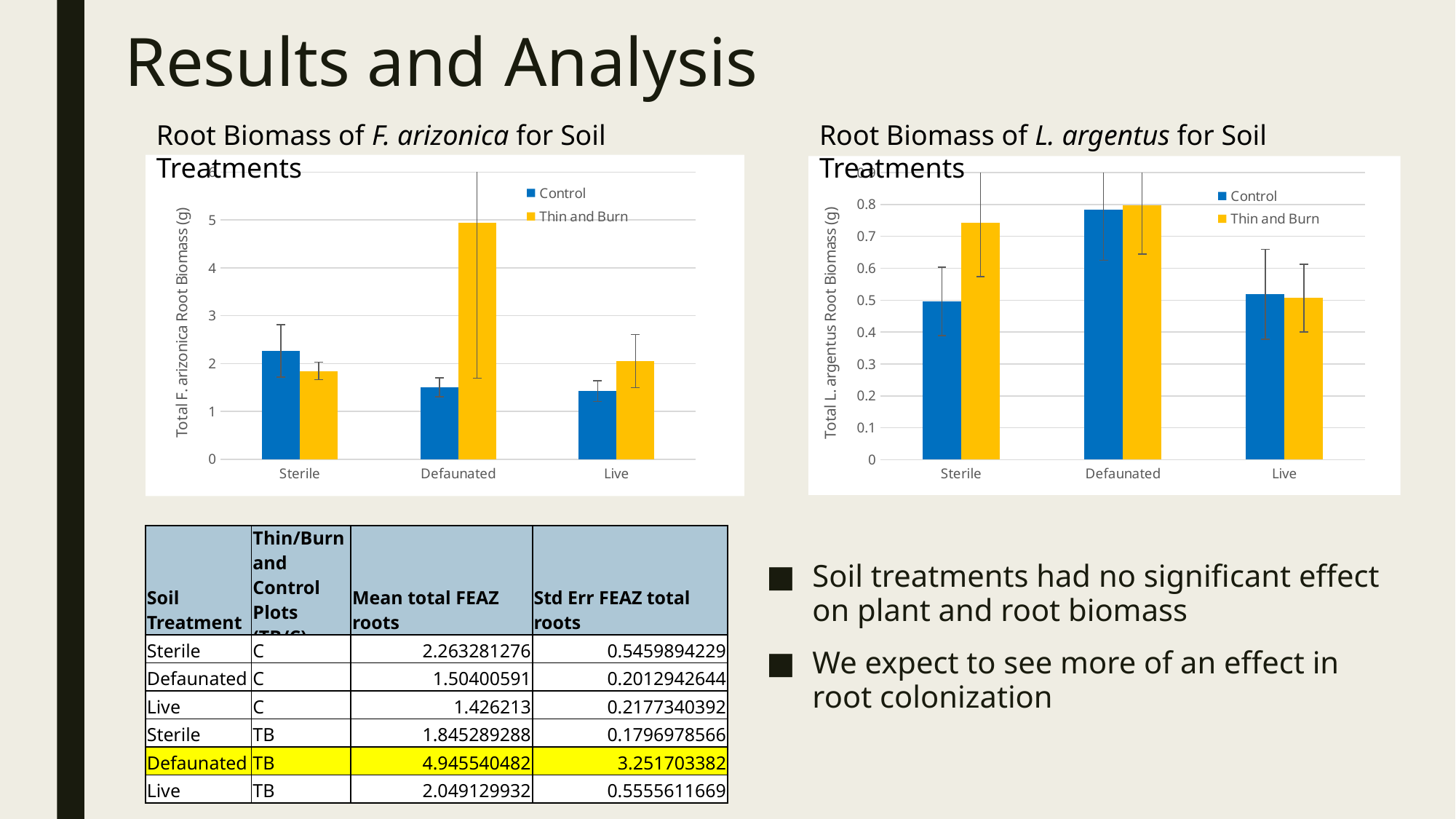
What is the y-axis title of the 'Root Biomass of L. argentus for Soil Treatments' chart? Total L. argentus Root Biomass (g) In the 'Root Biomass of L. argentus for Soil Treatments' chart, which category has the highest Control bar? Defaunated In the 'Root Biomass of F. arizonica for Soil Treatments' chart, is the Thin and Burn value for Defaunated greater or less than 4? greater In the 'Root Biomass of F. arizonica for Soil Treatments' chart, which category has the highest Thin and Burn bar? Defaunated In the 'Root Biomass of F. arizonica for Soil Treatments' chart, which is larger for Defaunated: Control or Thin and Burn? Thin and Burn In the 'Root Biomass of L. argentus for Soil Treatments' chart, is the Control value for Sterile greater or less than 0.6? less How many soil treatment categories are shown on the x axis of the 'Root Biomass of L. argentus for Soil Treatments' chart? 3 In the 'Root Biomass of F. arizonica for Soil Treatments' chart, is the Control value for Live greater or less than 2? less In the 'Root Biomass of L. argentus for Soil Treatments' chart, which category has the lowest Thin and Burn bar? Live What kind of chart is the 'Root Biomass of F. arizonica for Soil Treatments' chart? bar chart How many series does the legend of the 'Root Biomass of F. arizonica for Soil Treatments' chart list? 2 In the 'Root Biomass of F. arizonica for Soil Treatments' chart, which is larger for Sterile: Control or Thin and Burn? Control